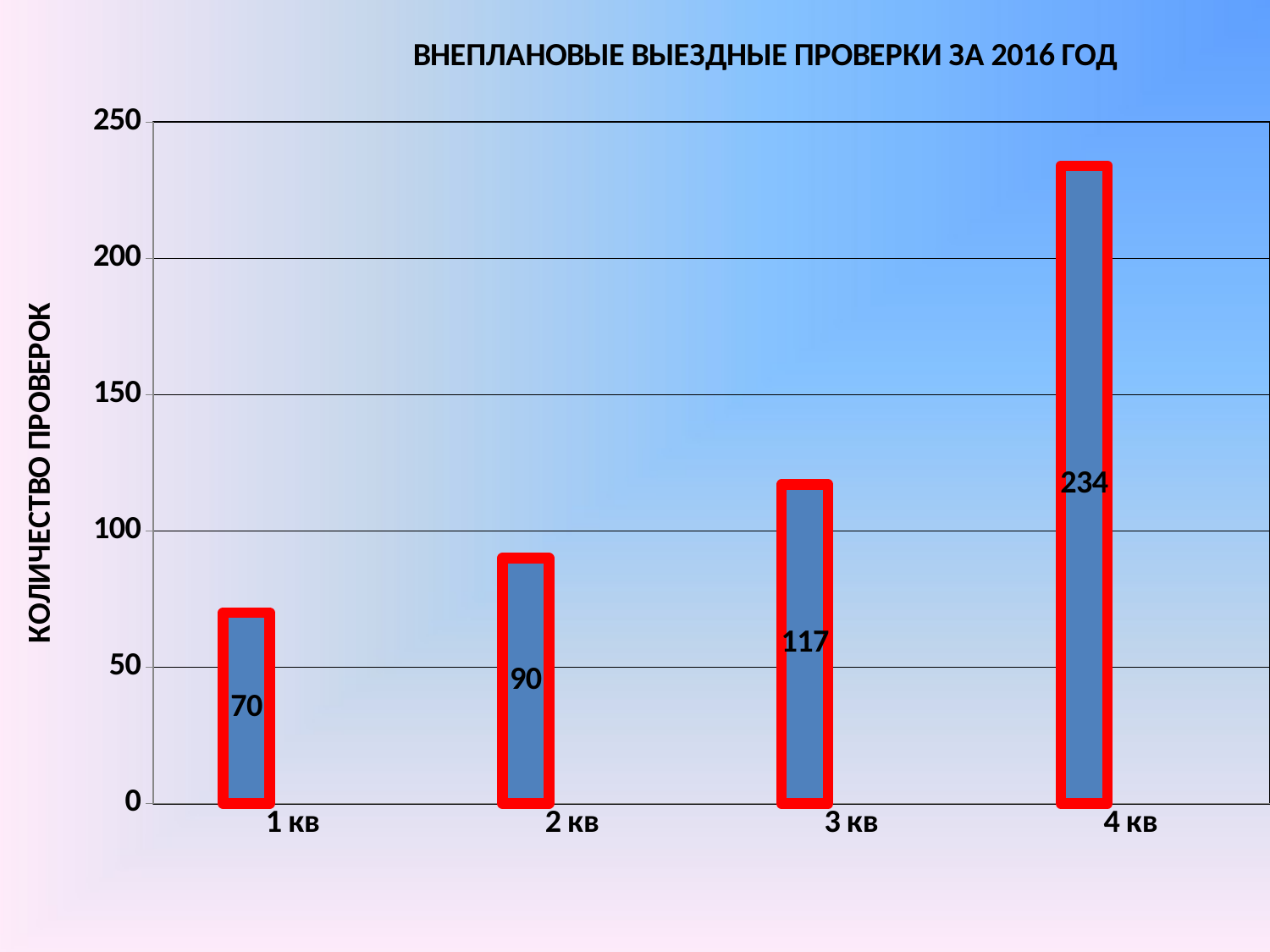
What is the value for 3 кв? 117 How many categories are shown on the x axis? 4 Which quarter has the highest number of inspections? 4 кв Which is larger, the value for 2 кв or the value for 3 кв? 3 кв What is the value for 4 кв? 234 Do the values rise or fall from 1 кв to 4 кв? rise What is the value for 1 кв? 70 Which quarter has the lowest number of inspections? 1 кв Is the value for 4 кв greater or less than 200? greater What kind of chart is shown on the slide? bar chart What is the difference between the values for 2 кв and 1 кв? 20 What is the difference between the values for 4 кв and 3 кв? 117